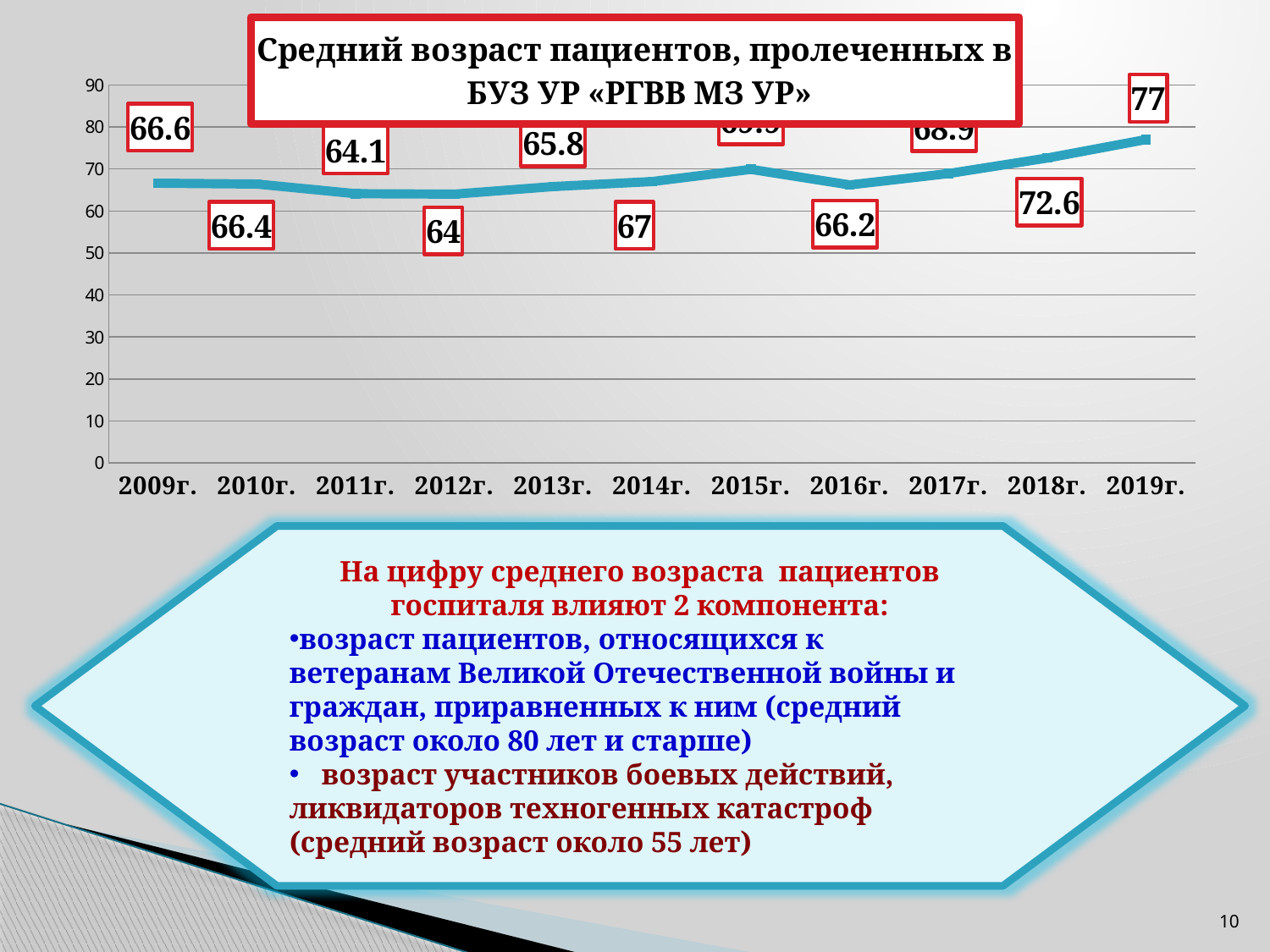
By how much did the value increase from 2009г. to 2019г.? 10.4 Is the value for 2015г. greater or less than 60? greater Which year has the larger value, 2016г. or 2018г.? 2018г. What is the value shown for 2014г.? 67 What is the value shown for 2018г.? 72.6 What is the average patient age shown for 2009г.? 66.6 What is the value plotted for 2019г.? 77 What is the value shown for 2012г.? 64 How many years are shown on the x axis of the chart? 11 Do the values rise or fall from 2016г. to 2019г.? rise What kind of chart is shown on the slide? line chart Which year has the highest average patient age on the chart? 2019г.